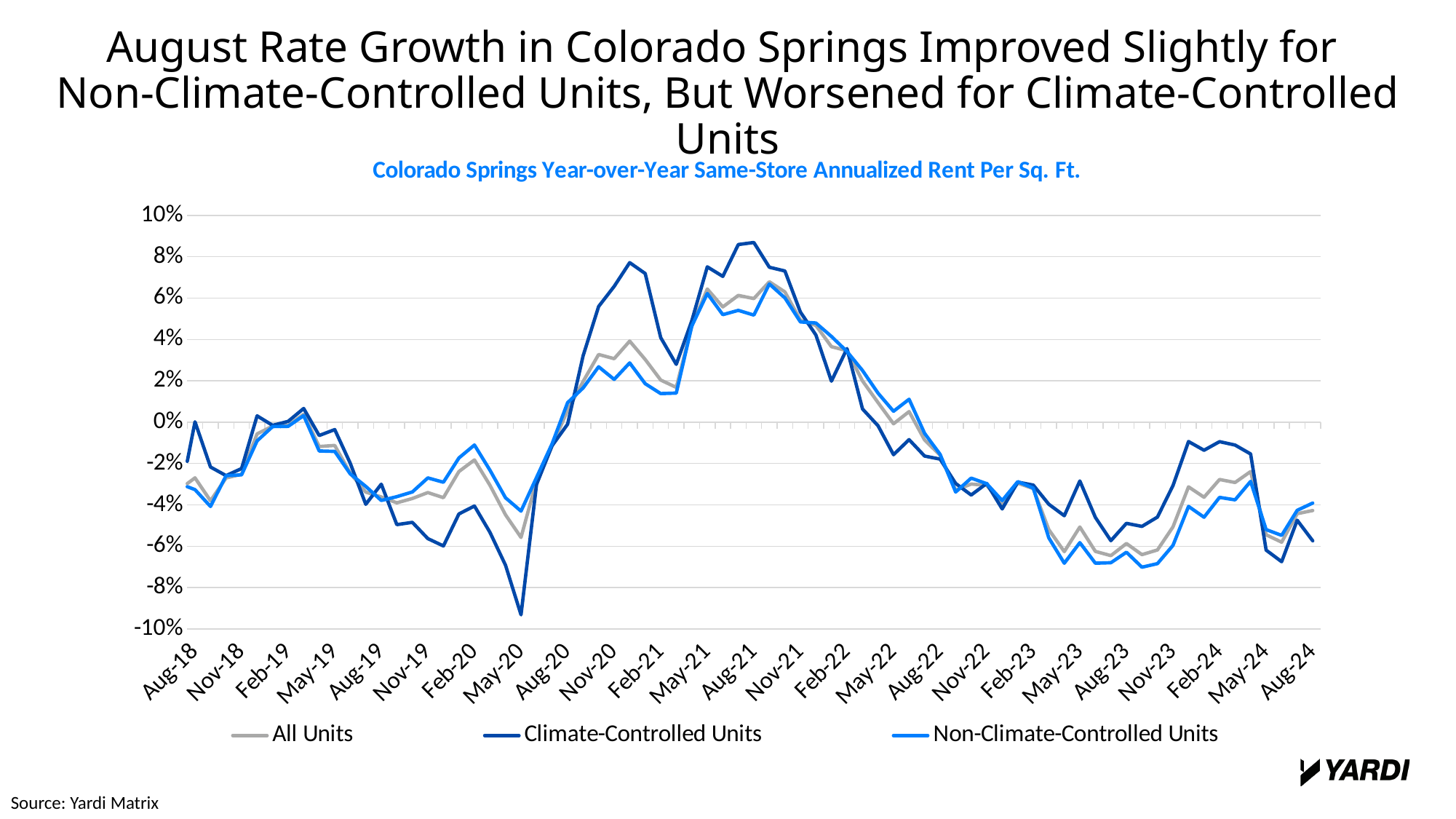
What is the blue subtitle of the chart? Colorado Springs Year-over-Year Same-Store Annualized Rent Per Sq. Ft. At Aug-21, which is higher: Climate-Controlled Units or Non-Climate-Controlled Units? Climate-Controlled Units Is the value for Climate-Controlled Units at Aug-21 greater or less than 8%? greater Which series reaches the lowest point on the chart? Climate-Controlled Units At May-20, which is lower: Climate-Controlled Units or Non-Climate-Controlled Units? Climate-Controlled Units Between Aug-21 and Aug-22, do the values for Climate-Controlled Units rise or fall? fall What kind of chart is shown on the slide? line chart Which series reaches the highest peak on the chart? Climate-Controlled Units How many series does the legend list? 3 Is the value for Climate-Controlled Units at Feb-24 greater or less than -2%? greater Is the value for Climate-Controlled Units at May-20 greater or less than -8%? less